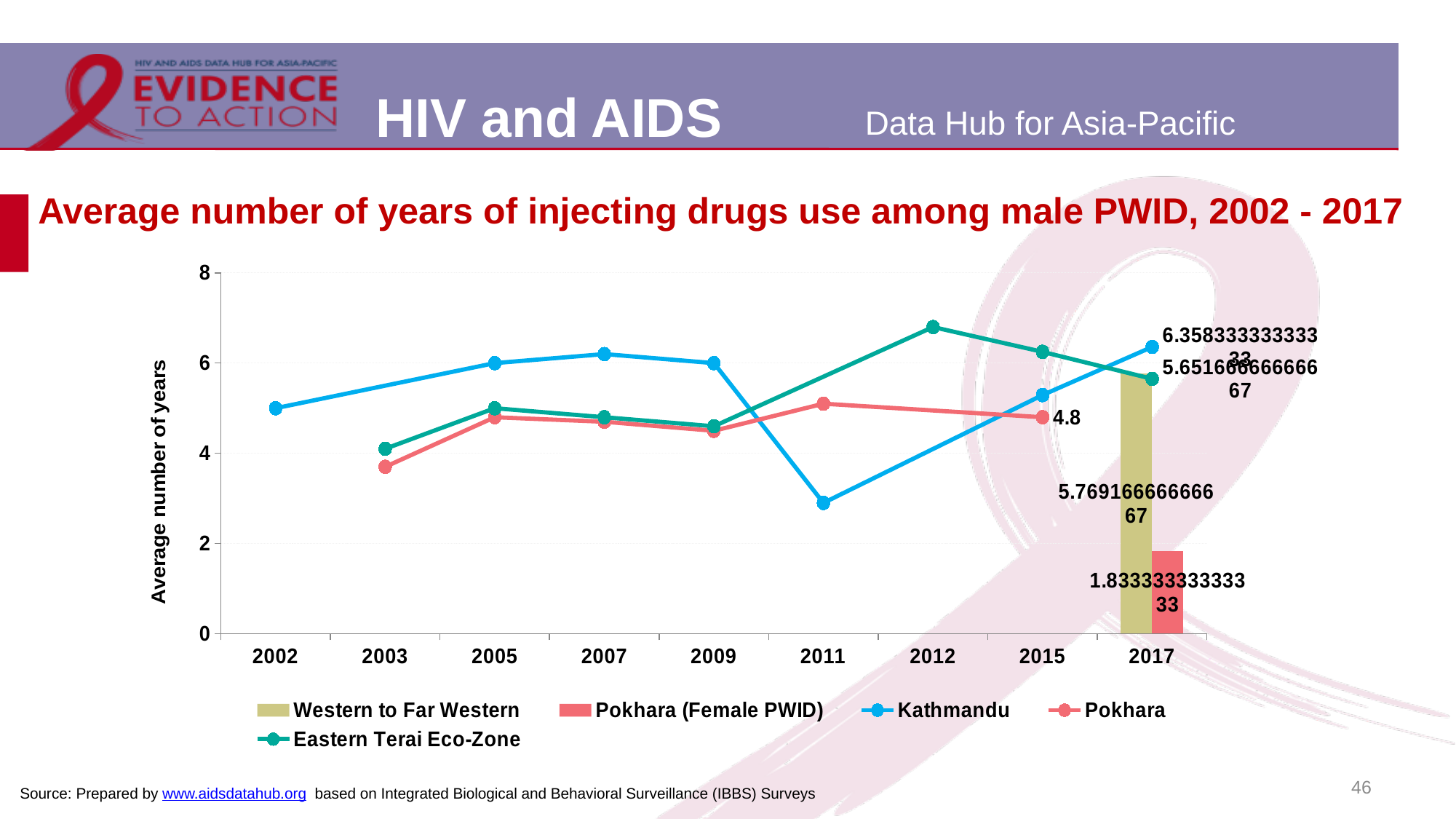
What is the value for Western to Far Western in 2017? 5.76916666666667 Is the value for Eastern Terai Eco-Zone in 2012 greater or less than 6? greater In which year is the Eastern Terai Eco-Zone value highest? 2012 In which year is the Kathmandu value lowest? 2011 How many series does the legend list? 5 In 2017, which is larger: Kathmandu or Eastern Terai Eco-Zone? Kathmandu What is the value for Pokhara in 2015? 4.8 How many years are shown on the x axis? 9 What kind of chart is shown on the slide? A combined line and bar chart What is the value for Pokhara (Female PWID) in 2017? 1.83333333333333 Is the value for Kathmandu in 2011 greater or less than 4? less Do the Kathmandu values rise or fall from 2011 to 2017? rise